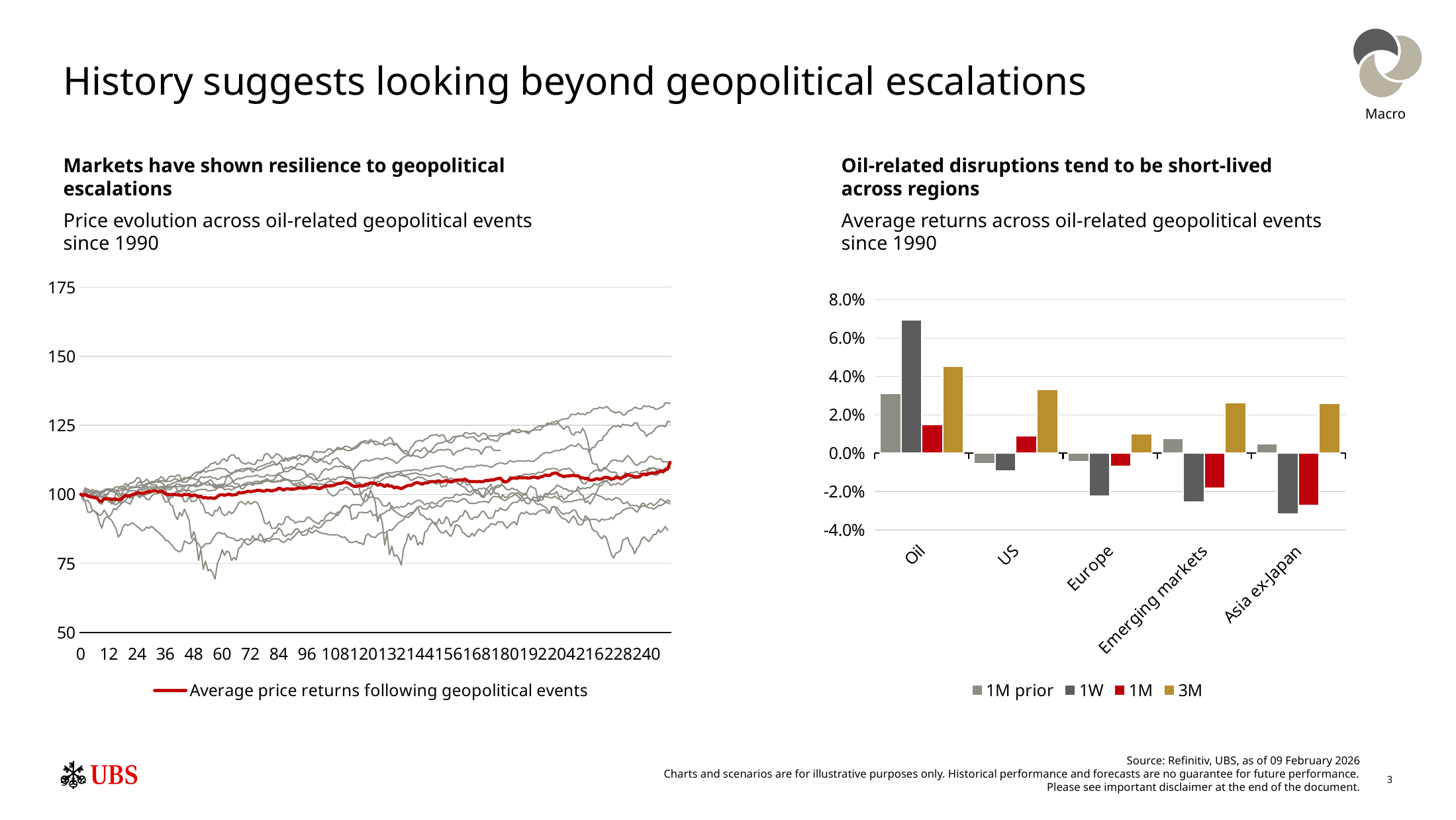
In the right chart, is the 1W value for Emerging markets greater or less than -2.0%? less In the right chart, which category has the lowest 1W value? Asia ex-Japan What kind of chart is the chart on the right, 'Oil-related disruptions tend to be short-lived across regions'? bar chart In the right chart, which category has the highest 1W value? Oil In the right chart, is the 3M value for Oil greater or less than 4.0%? greater In the right chart, is the 1W value for Oil greater or less than 6.0%? greater In the right chart, how many categories are shown on the x axis? 5 In the left chart, does the red average line rise or fall overall from 0 to 240 on the x axis? rise In the right chart, which is larger for US: the 3M value or the 1M value? 3M In the right chart, how many series does the legend list? 4 In the left chart, what series does the legend name for the red line? Average price returns following geopolitical events What kind of chart is the chart on the left, 'Markets have shown resilience to geopolitical escalations'? line chart